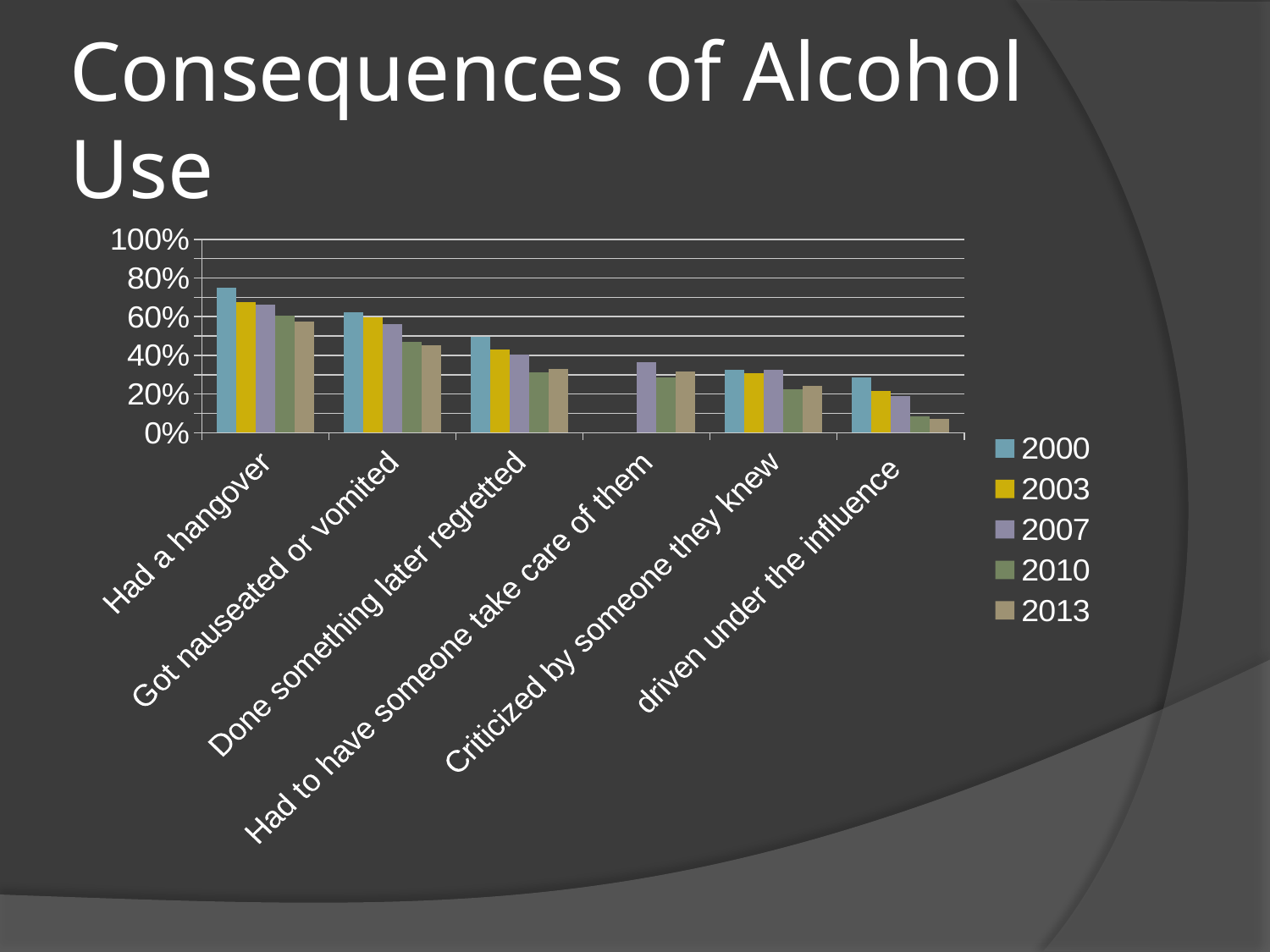
Which years are listed in the legend? 2000, 2003, 2007, 2010, 2013 What is the title of the slide containing the chart? Consequences of Alcohol Use How many consequence categories are shown on the x axis? 6 Is the 2010 value for 'Got nauseated or vomited' greater or less than 40%? greater Which category has the highest value for the 2000 series? Had a hangover Which is larger for 'Done something later regretted': the 2000 value or the 2013 value? 2000 For 'Had a hangover', do the values rise or fall from 2000 to 2013? fall Is the 2000 value for 'Had a hangover' greater or less than 60%? greater Which category has the lowest value for the 2013 series? driven under the influence Is the 2013 value for 'driven under the influence' greater or less than 20%? less What kind of chart is shown on the slide? bar chart How many series does the legend list? 5